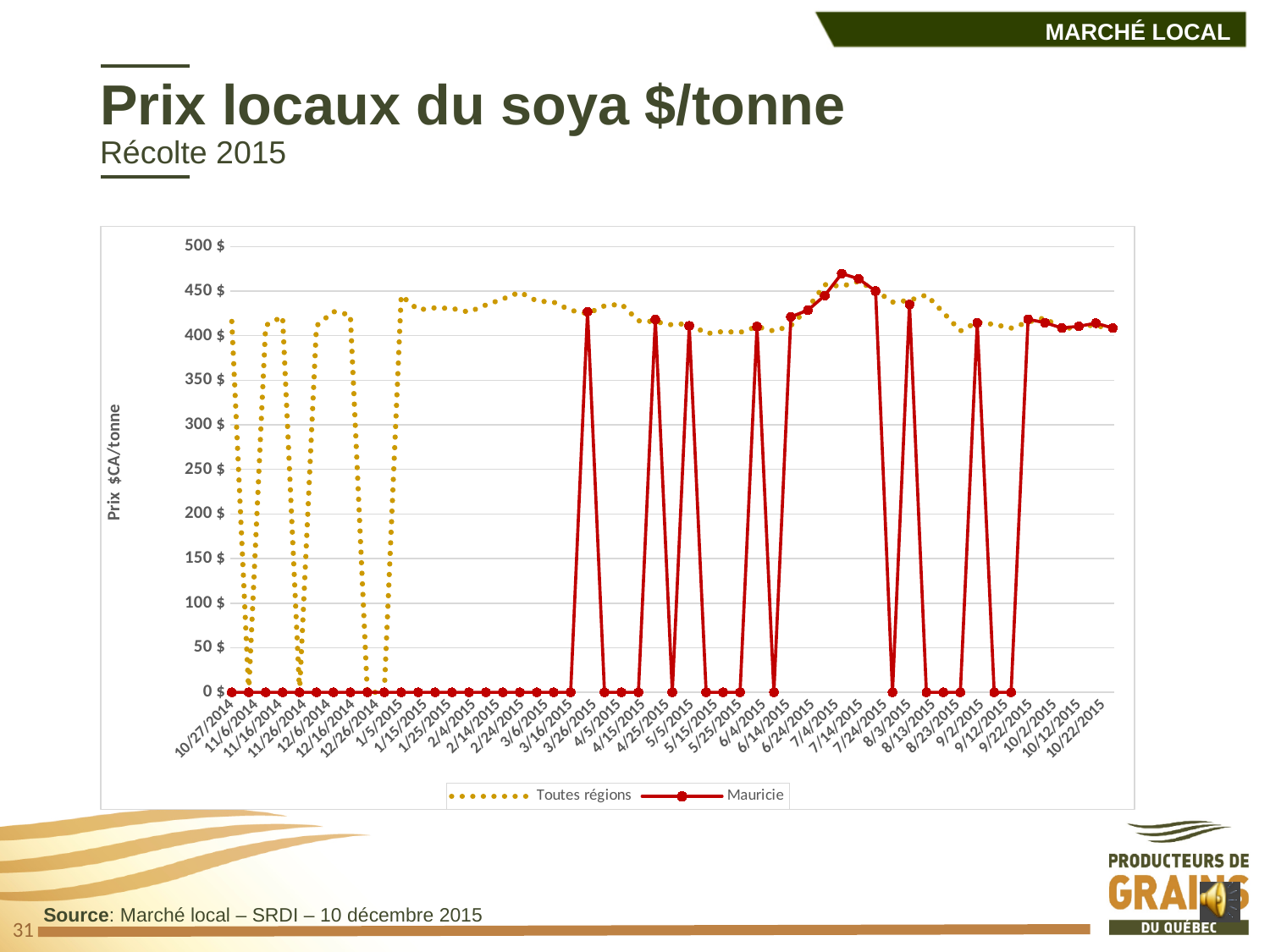
How many series does the legend list? 2 What is the value for Mauricie on 1/15/2015? 0 $ Between 7/4/2015 and 9/2/2015, does the Toutes régions series rise or fall? fall What are the two series named in the legend? Toutes régions and Mauricie What kind of chart is shown on the slide? line chart Around which date does the Mauricie series reach its highest value? 7/4/2015 Is the value for Mauricie on 10/22/2015 greater or less than 450 $? less Is the value for Toutes régions on 10/27/2014 greater or less than 400 $? greater Which is larger for Mauricie: the value on 7/4/2015 or the value on 10/22/2015? 7/4/2015 What is the label on the vertical axis? Prix $CA/tonne What is the value for Mauricie on 3/16/2015? 0 $ Is the value for Mauricie on 7/4/2015 greater or less than 450 $? greater